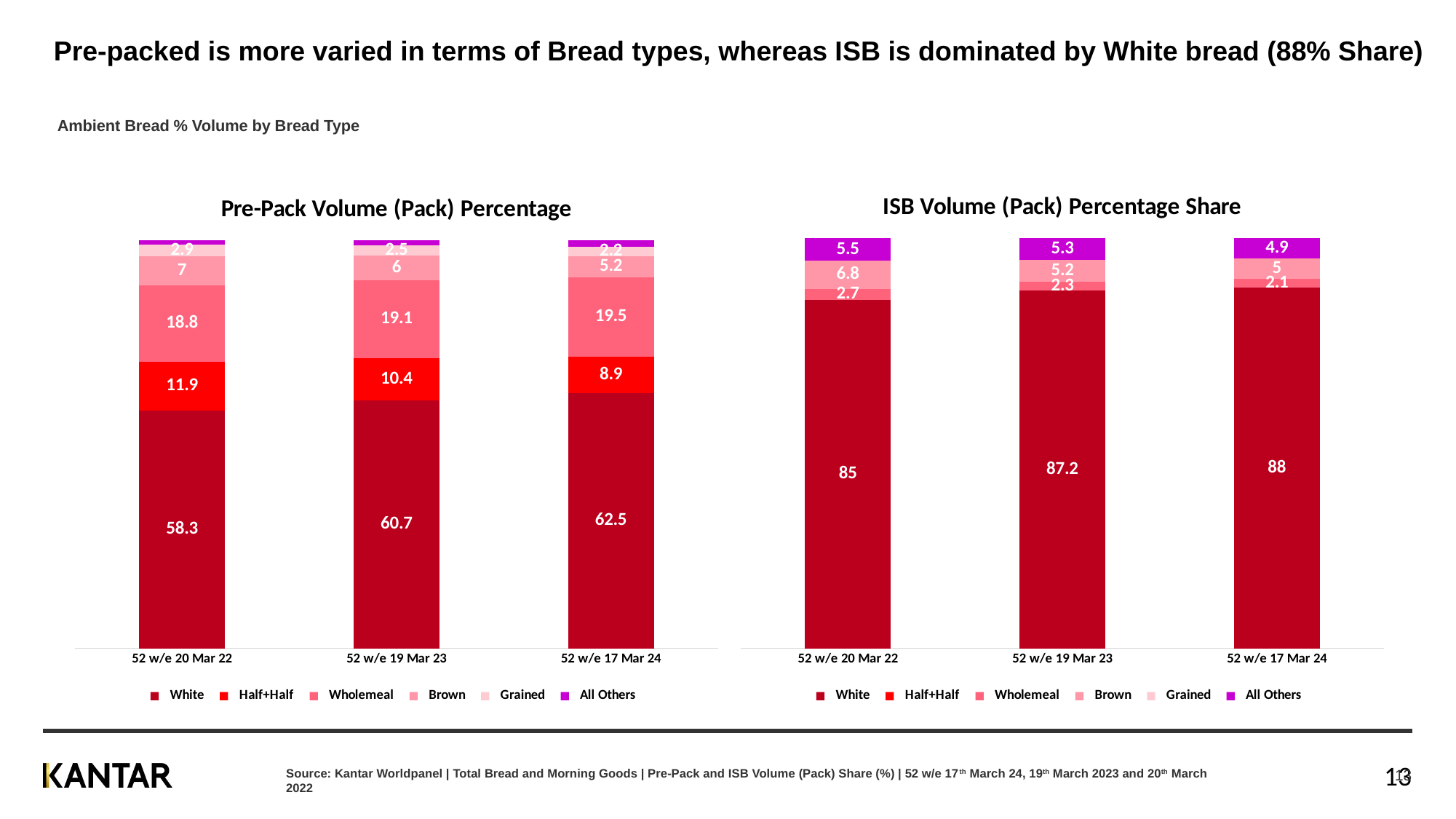
In the Pre-Pack Volume (Pack) Percentage chart, does the Half+Half value rise or fall across the three periods? Falls In the Pre-Pack Volume (Pack) Percentage chart, which is larger in 52 w/e 17 Mar 24: Wholemeal or Half+Half? Wholemeal How many time periods are shown on the x axis of the ISB Volume (Pack) Percentage Share chart? 3 In the ISB Volume (Pack) Percentage Share chart, what is the value for White in 52 w/e 20 Mar 22? 85 In the ISB Volume (Pack) Percentage Share chart, how much higher is the White value in 52 w/e 17 Mar 24 than in 52 w/e 20 Mar 22? 3 In the Pre-Pack Volume (Pack) Percentage chart, what is the value for Half+Half in 52 w/e 19 Mar 23? 10.4 In the Pre-Pack Volume (Pack) Percentage chart, what is the value for White in 52 w/e 17 Mar 24? 62.5 In the Pre-Pack Volume (Pack) Percentage chart, what is the difference between the White value in 52 w/e 17 Mar 24 and in 52 w/e 20 Mar 22? 4.2 In the ISB Volume (Pack) Percentage Share chart, what is the value for All Others in 52 w/e 17 Mar 24? 4.9 What kind of chart is the Pre-Pack Volume (Pack) Percentage chart? Stacked bar chart In the Pre-Pack Volume (Pack) Percentage chart, does the White value rise or fall across the three periods? Rises How many series does the legend of the Pre-Pack Volume (Pack) Percentage chart list? 6